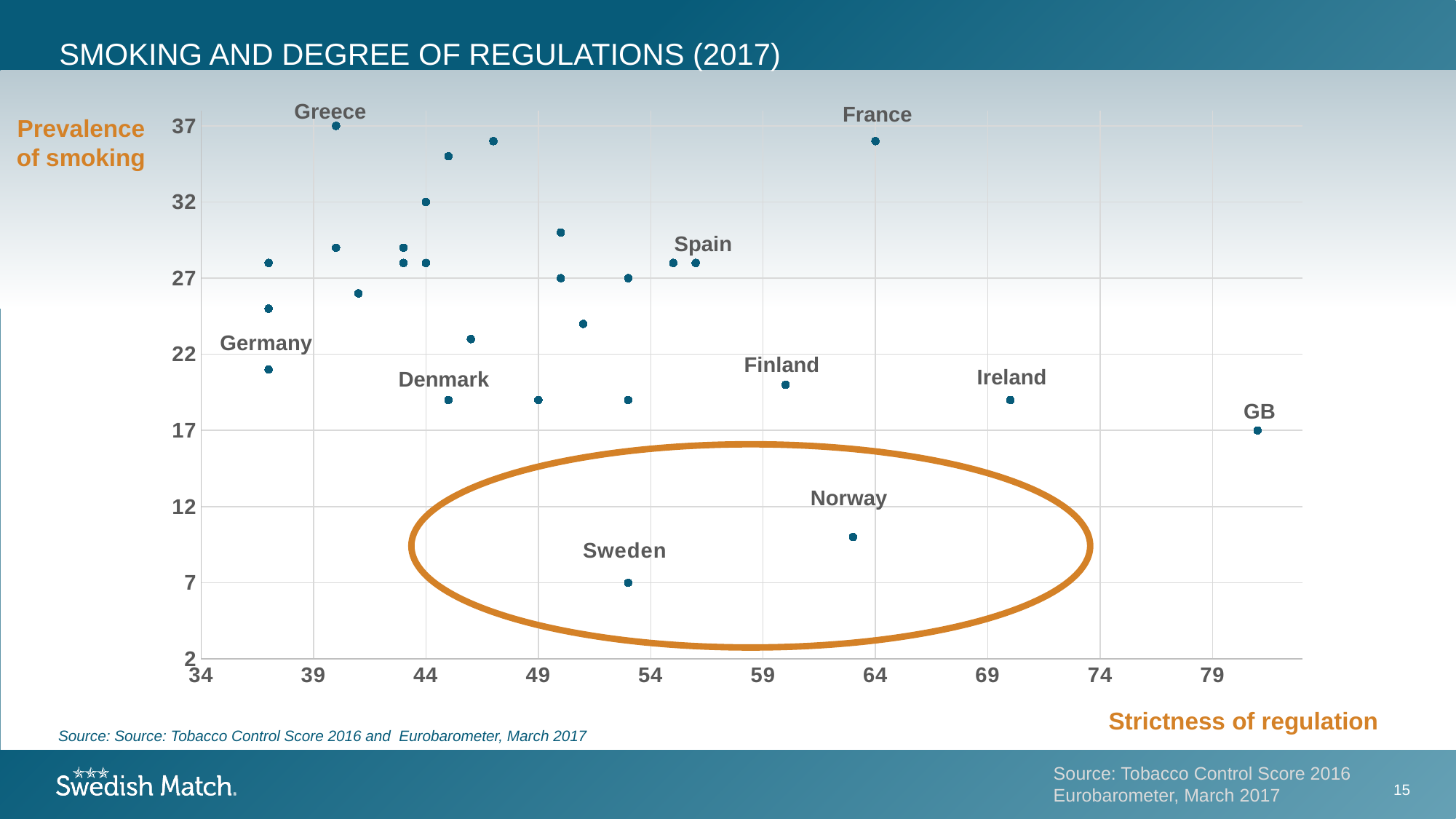
Is the strictness of regulation for Germany greater or less than 39? less What is the label of the horizontal axis? Strictness of regulation Which labelled country has the highest prevalence of smoking? Greece Which has a higher prevalence of smoking, France or Finland? France What is the prevalence of smoking for Greece? 37 What is the prevalence of smoking for Sweden? 7 Which labelled country has the highest strictness of regulation? GB Is the prevalence of smoking for France greater or less than 32? greater Is the prevalence of smoking for Norway greater or less than 12? less What is the prevalence of smoking for GB? 17 What kind of chart is shown on the slide? scatter chart Which labelled country has the lowest prevalence of smoking? Sweden